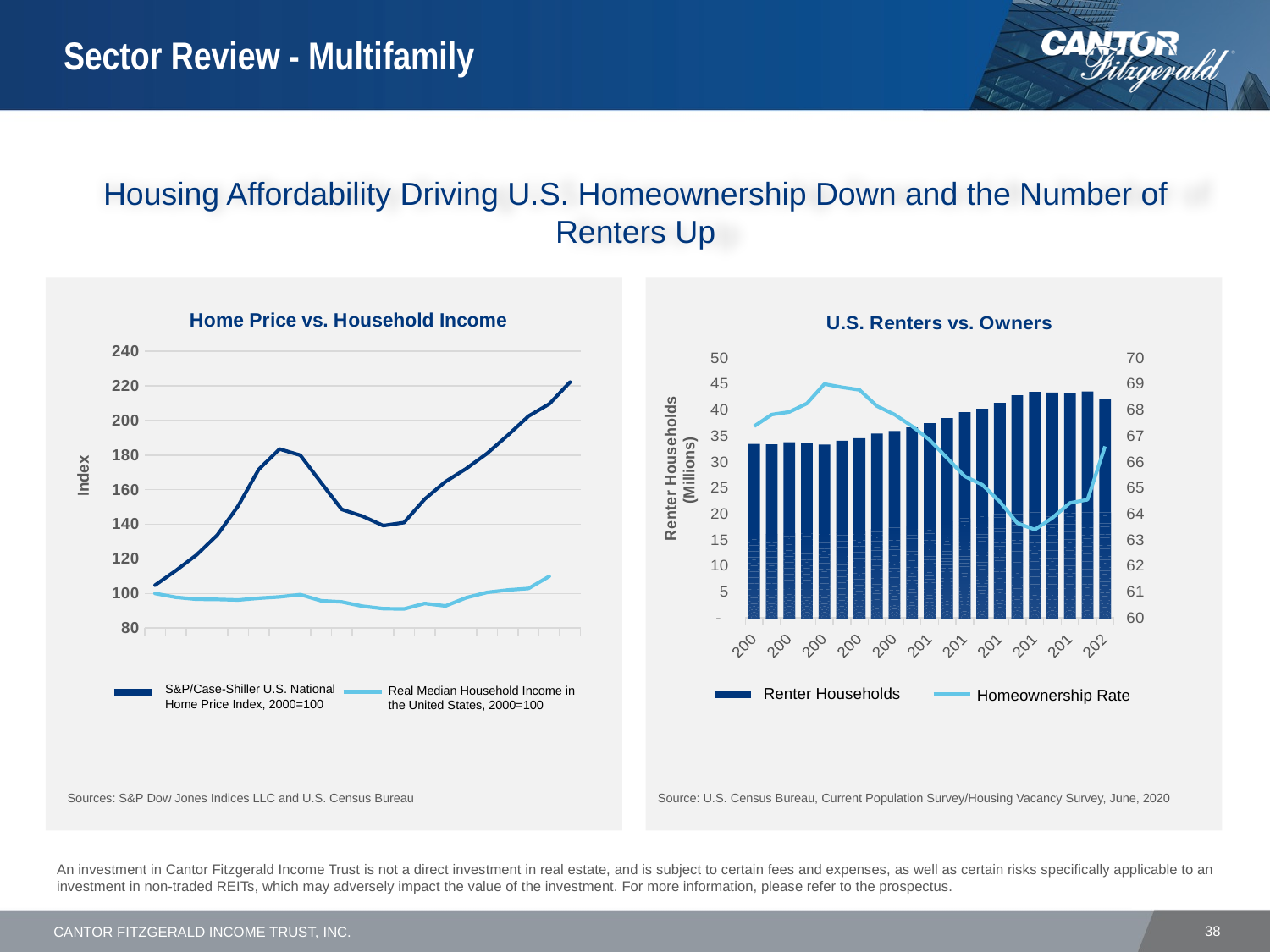
In the "U.S. Renters vs. Owners" chart, do the Renter Households bars overall rise or fall from left to right along the x axis? rise How many series does the legend of the "U.S. Renters vs. Owners" chart list? 2 In the "Home Price vs. Household Income" chart, which series ends higher at the right end of the x axis, the Home Price Index or the Real Median Household Income? S&P/Case-Shiller U.S. National Home Price Index In the "Home Price vs. Household Income" chart, does the S&P/Case-Shiller U.S. National Home Price Index overall rise or fall from the left end to the right end of the x axis? rise In the "U.S. Renters vs. Owners" chart, is the value of the first Renter Households bar greater or less than 30? greater In the "Home Price vs. Household Income" chart, is the final value of the Real Median Household Income series greater or less than 140? less In the "Home Price vs. Household Income" chart, is the final value of the S&P/Case-Shiller U.S. National Home Price Index greater or less than 200? greater How many series does the legend of the "Home Price vs. Household Income" chart list? 2 What kind of chart is the "Home Price vs. Household Income" chart? line chart In the "U.S. Renters vs. Owners" chart, which series is drawn as bars? Renter Households In the "Home Price vs. Household Income" chart, what is the name of the dark blue series? S&P/Case-Shiller U.S. National Home Price Index, 2000=100